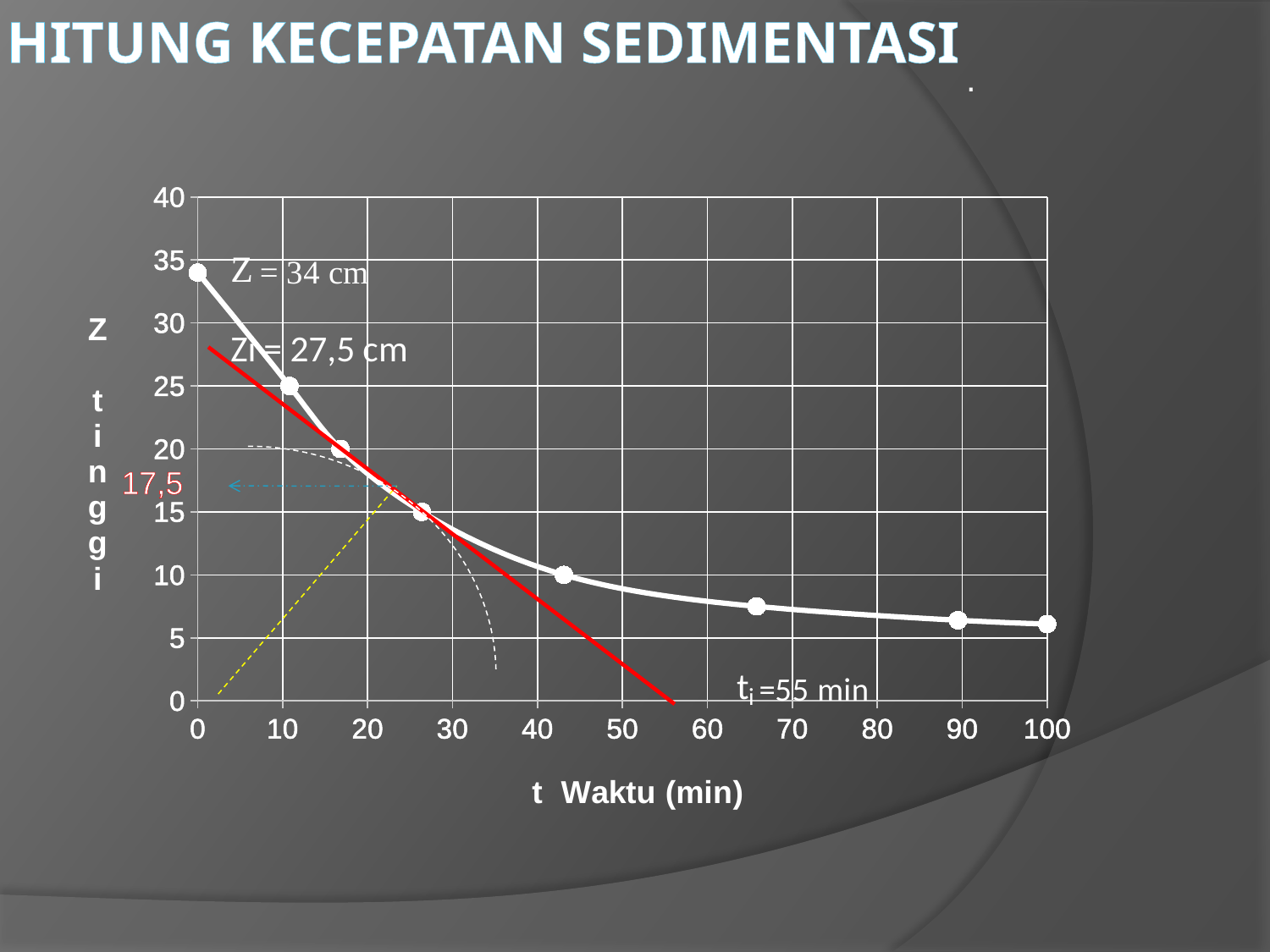
Do the plotted values rise or fall as time increases along the x axis? fall What is the label of the x axis? t Waktu (min) How many data points are plotted on the curve? 8 Which is larger, the value of Z at t = 0 min or at t = 100 min? t = 0 min Is the value of Z at t = 0 min greater or less than 30? greater What is the title of the slide? HITUNG KECEPATAN SEDIMENTASI What value of ti is annotated on the chart? 55 min What value of Zi is annotated on the chart? 27,5 cm What kind of chart is shown on the slide? line chart Is the value of Z at t = 100 min greater or less than 10? less What is the value of Z at t = 0 min, as annotated on the chart? 34 cm At which time is the plotted height Z the highest? 0 min